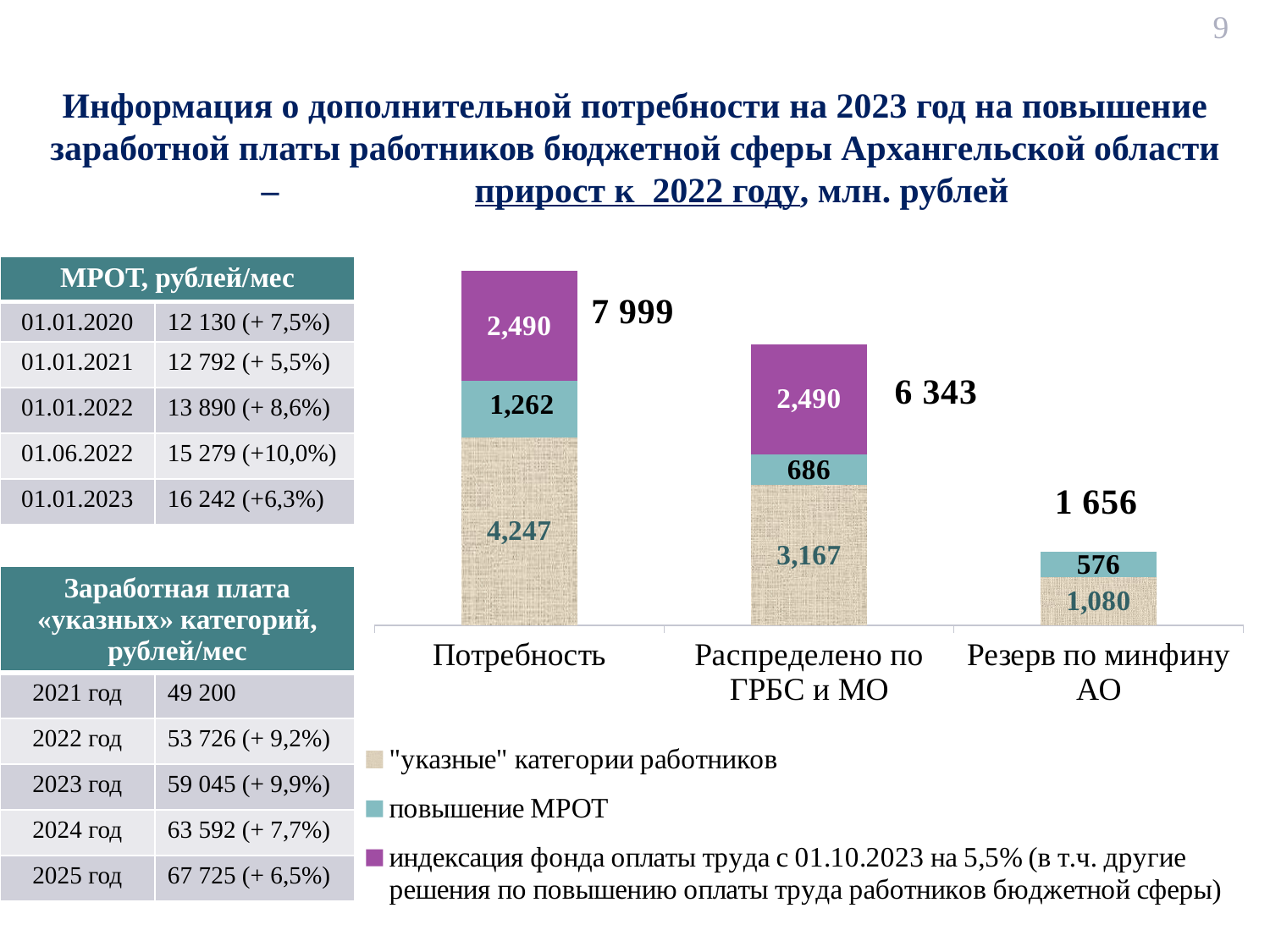
What is the value of the "указные" категории работников segment for Резерв по минфину АО? 1,080 What is the total shown for Распределено по ГРБС и МО? 6 343 What is the value of the повышение МРОТ segment for Распределено по ГРБС и МО? 686 What kind of chart is shown on the slide? stacked bar chart How many series does the chart legend list? 3 Which category has the lowest total? Резерв по минфину АО Which category has no индексация фонда оплаты труда segment? Резерв по минфину АО What is the total shown above the Потребность bar? 7 999 How many categories are shown on the x axis of the chart? 3 What is the difference between the повышение МРОТ values for Потребность and Распределено по ГРБС и МО? 576 Which is larger: the "указные" категории работников segment for Потребность or for Распределено по ГРБС и МО? Потребность What is the value of the "указные" категории работников segment for Потребность? 4,247